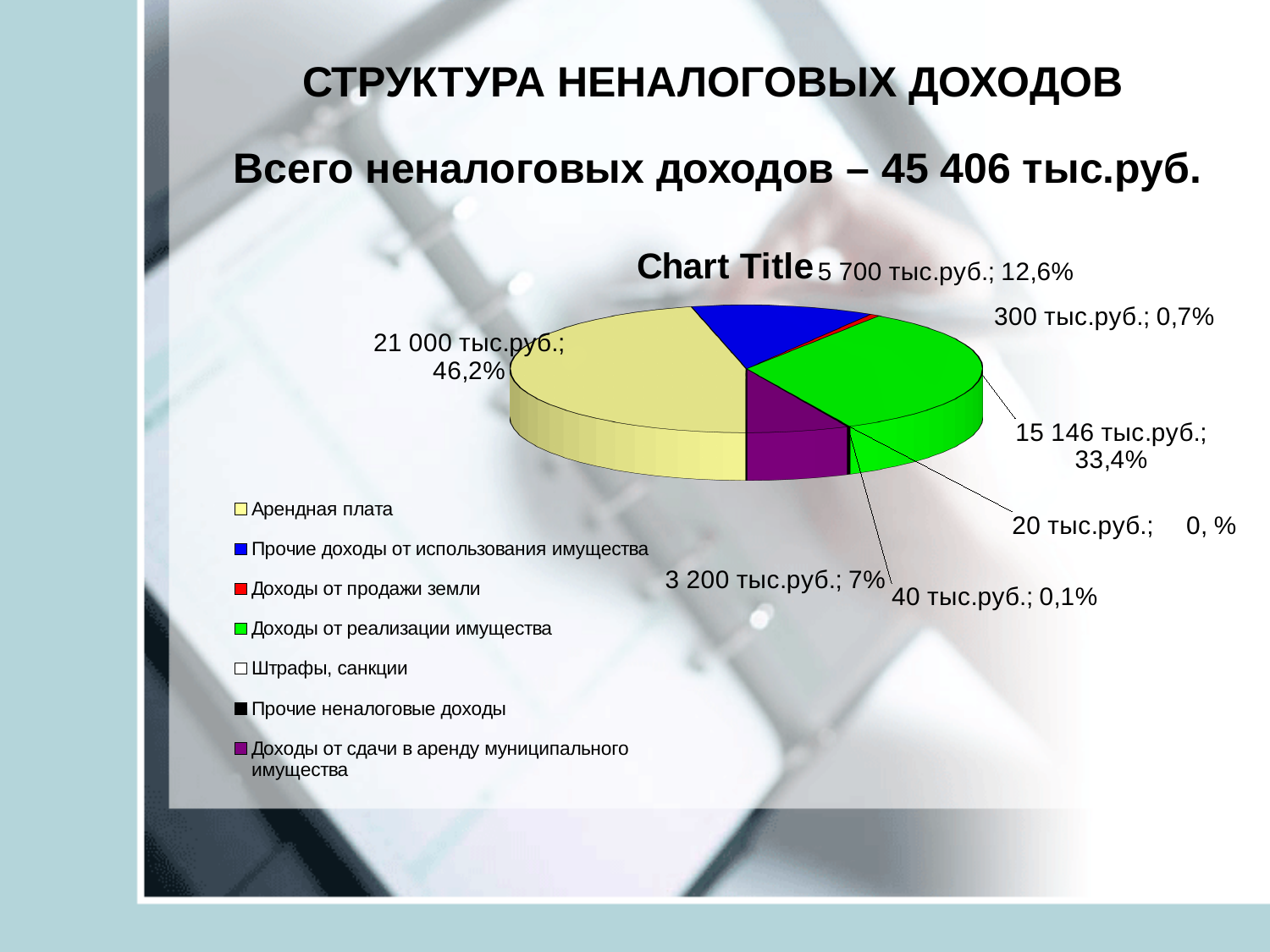
What is the value shown for Доходы от сдачи в аренду муниципального имущества? 3 200 тыс.руб. What share of the pie does Доходы от реализации имущества take? 33,4% What share of the pie does Арендная плата take? 46,2% What is the title printed above the pie chart? Chart Title What is the value shown for Арендная плата? 21 000 тыс.руб. What share of the pie does Доходы от продажи земли take? 0,7% How many entries does the chart legend list? 7 What kind of chart is shown on the slide? pie chart What is the value shown for Доходы от реализации имущества? 15 146 тыс.руб. Which category has the largest slice of the pie? Арендная плата What is the difference between the values for Арендная плата and Доходы от реализации имущества? 5 854 тыс.руб. What is the value shown for Прочие доходы от использования имущества? 5 700 тыс.руб.